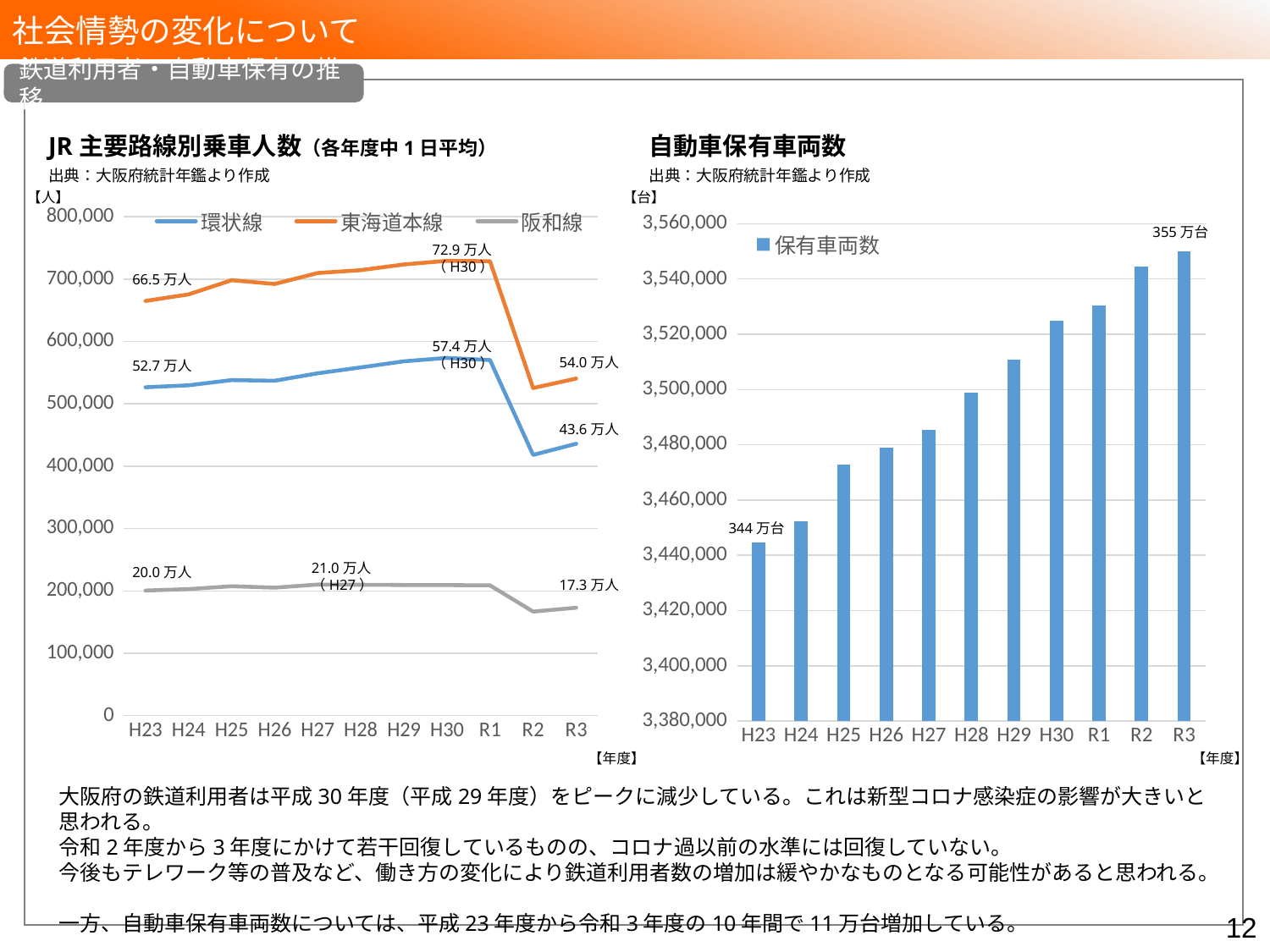
On the JR主要路線別乗車人数 chart, what is the labelled value for 東海道本線 in H30? 72.9万人 On the JR主要路線別乗車人数 chart, what kind of chart is it? line chart On the JR主要路線別乗車人数 chart, what is the difference between the 東海道本線 labels for H23 (66.5万人) and R3 (54.0万人)? 12.5万人 On the 自動車保有車両数 chart, what is the labelled value for R3? 355万台 On the 自動車保有車両数 chart, do the values rise or fall from H23 to R3? rise On the JR主要路線別乗車人数 chart, which line has the highest values throughout? 東海道本線 On the JR主要路線別乗車人数 chart, what is the labelled value for 環状線 in R3? 43.6万人 On the JR主要路線別乗車人数 chart, how many series does the legend list? 3 On the JR主要路線別乗車人数 chart, is the 環状線 value for R2 greater or less than 500,000? less On the 自動車保有車両数 chart, how many fiscal years are shown on the x axis? 11 On the JR主要路線別乗車人数 chart, what is the labelled value for 阪和線 in H27? 21.0万人